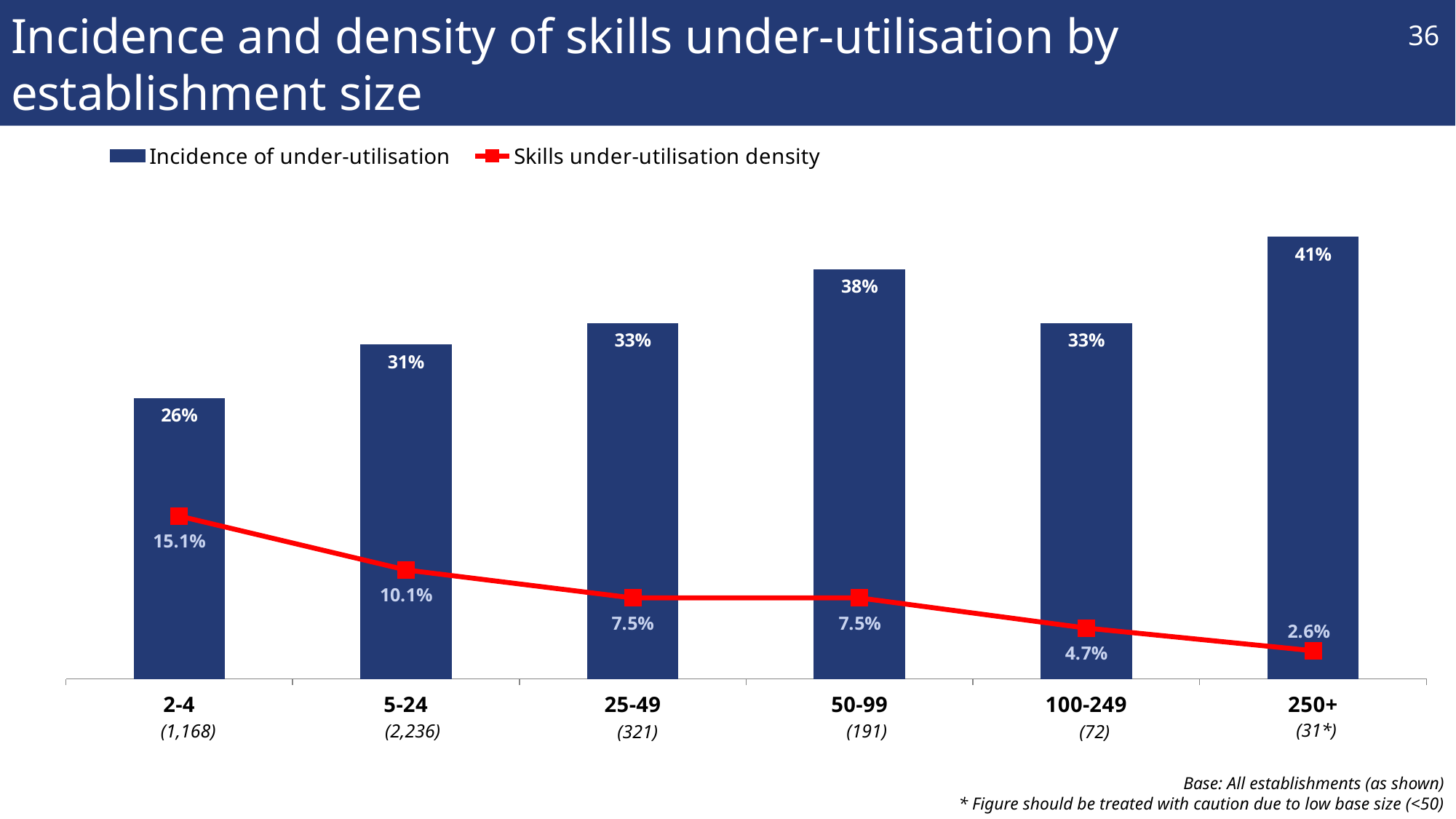
What is the incidence of under-utilisation for establishments with 50-99 employees? 38% What is the skills under-utilisation density for establishments with 5-24 employees? 10.1% What kind of chart is used to show the incidence of under-utilisation? Bar chart Which has a higher incidence of under-utilisation: establishments with 5-24 employees or those with 50-99 employees? 50-99 Which establishment size has the lowest skills under-utilisation density? 250+ What is the difference in skills under-utilisation density between the 2-4 and 100-249 size bands? 10.4 percentage points Which establishment size has the highest incidence of under-utilisation? 250+ What is the difference in incidence of under-utilisation between the 250+ and 2-4 size bands? 15 percentage points Does the skills under-utilisation density generally rise or fall as establishment size increases? Fall Which establishment size has the lowest incidence of under-utilisation? 2-4 How many establishment size bands are shown on the x axis? 6 How many series does the legend list? 2